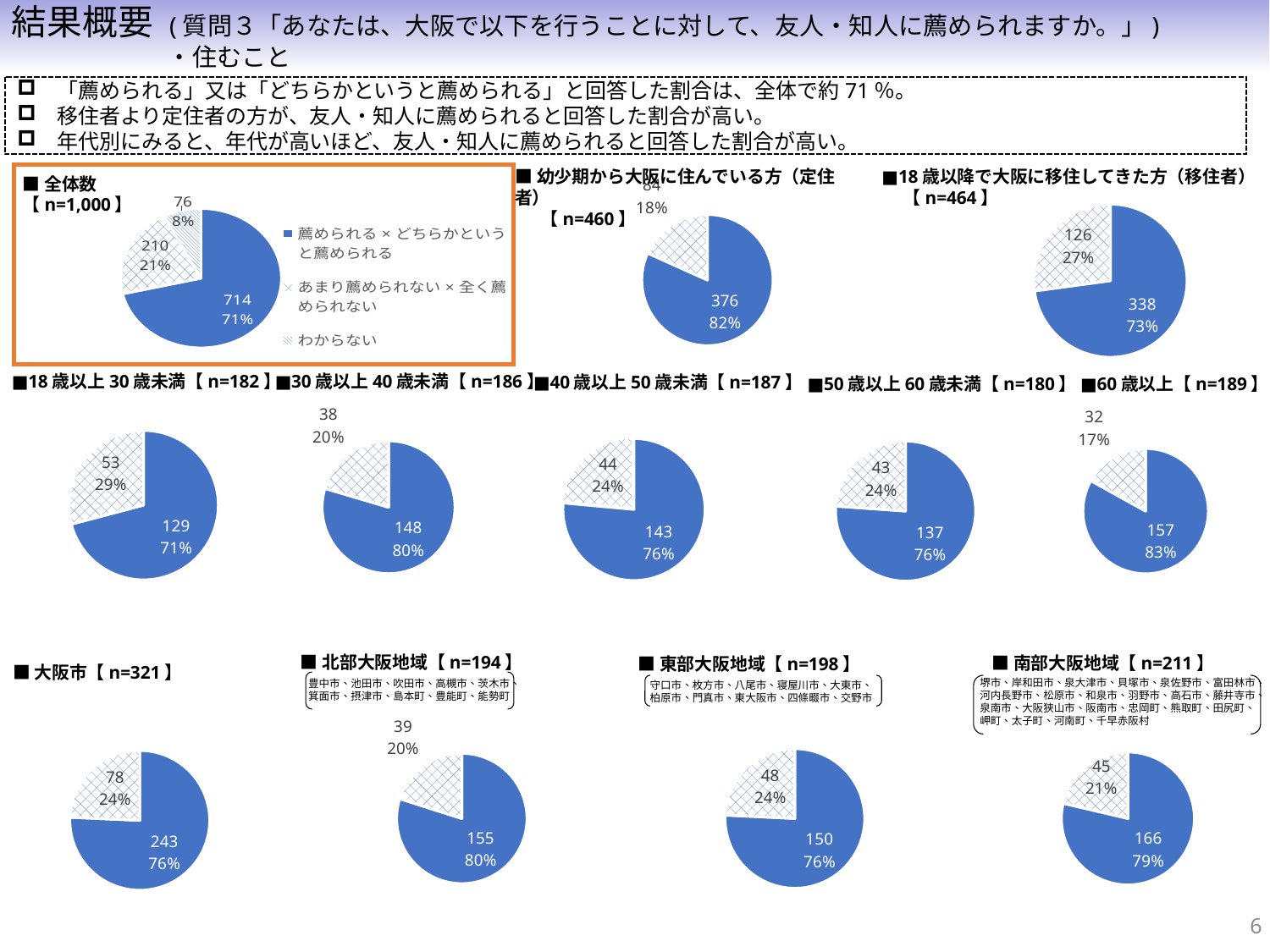
In the 大阪市 pie chart, what is the count for the hatched slice? 78 In the 60歳以上 pie chart, what is the count for the blue slice? 157 How many entries does the legend of the 全体数 pie chart list? 3 In the 幼少期から大阪に住んでいる方（定住者） pie chart, what is the value of the larger slice? 376 In the 全体数 pie chart, what percentage share does わからない have? 8% What is the difference in the blue-slice count between the 北部大阪地域 pie chart and the 東部大阪地域 pie chart? 5 In the 18歳以降で大阪に移住してきた方（移住者） pie chart, what percentage is shown for the smaller slice? 27% Among the five age-group pie charts, which age group has the lowest percentage for the blue slice? 18歳以上30歳未満 In the 全体数 pie chart, what is the count for 薦められる×どちらかというと薦められる? 714 Which pie chart shows a larger percentage for the blue slice: 幼少期から大阪に住んでいる方（定住者） or 18歳以降で大阪に移住してきた方（移住者）? 幼少期から大阪に住んでいる方（定住者） Among the five age-group pie charts, which age group has the highest percentage for the blue slice? 60歳以上 What type of chart is used for the 幼少期から大阪に住んでいる方（定住者） data? Pie chart